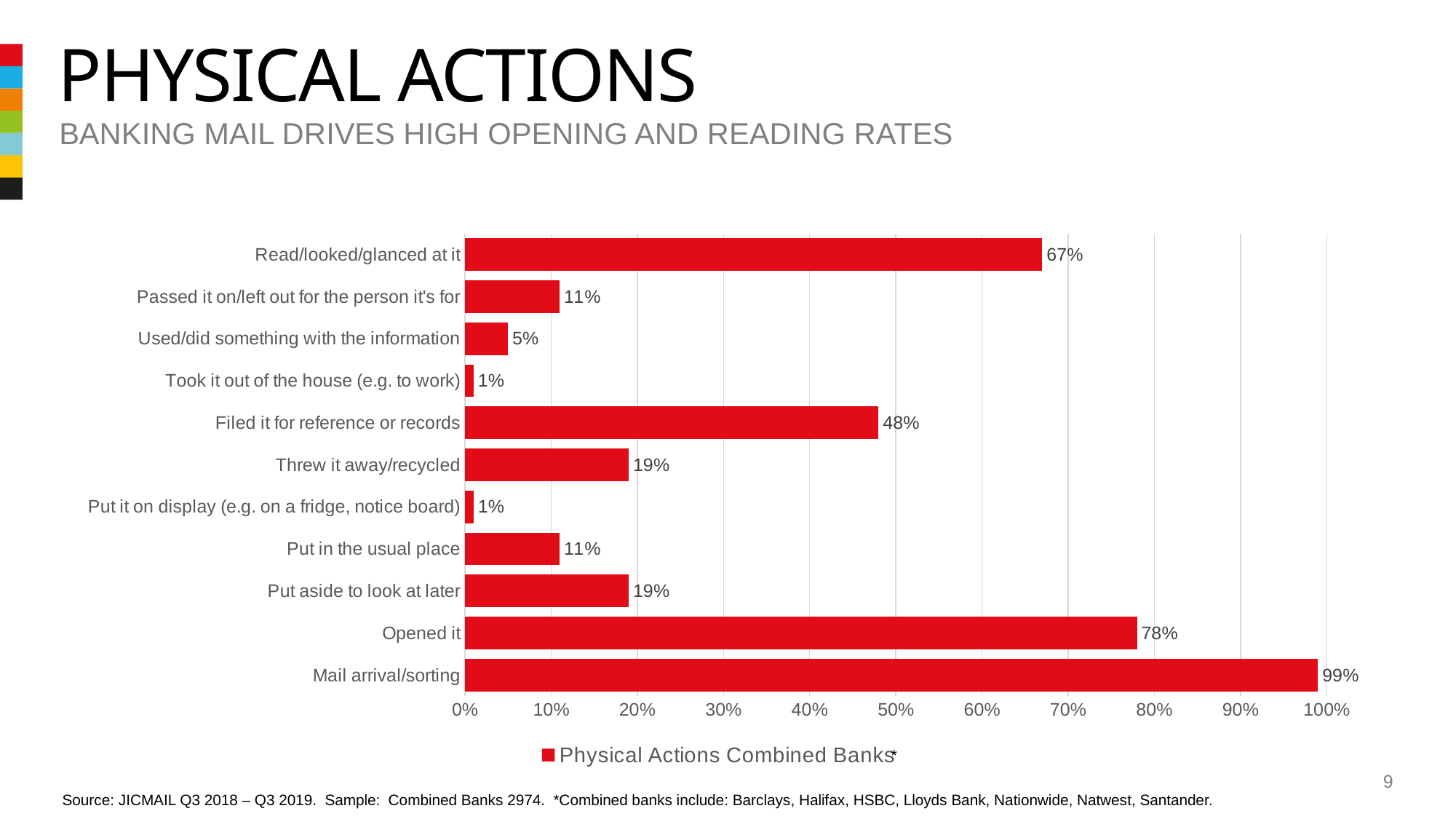
How many series does the legend list? 1 What is the difference between "Mail arrival/sorting" and "Opened it"? 21% Which is larger, "Threw it away/recycled" or "Passed it on/left out for the person it's for"? Threw it away/recycled What is the difference between "Read/looked/glanced at it" and "Filed it for reference or records"? 19% What kind of chart is shown on the slide? Bar chart How many categories are shown in the chart? 11 Is the value for "Read/looked/glanced at it" greater or less than 60%? greater What is the value for "Used/did something with the information"? 5% What is the value for "Filed it for reference or records"? 48% What is the legend entry for the series shown? Physical Actions Combined Banks* What is the value for "Opened it"? 78% Which category has the highest value? Mail arrival/sorting